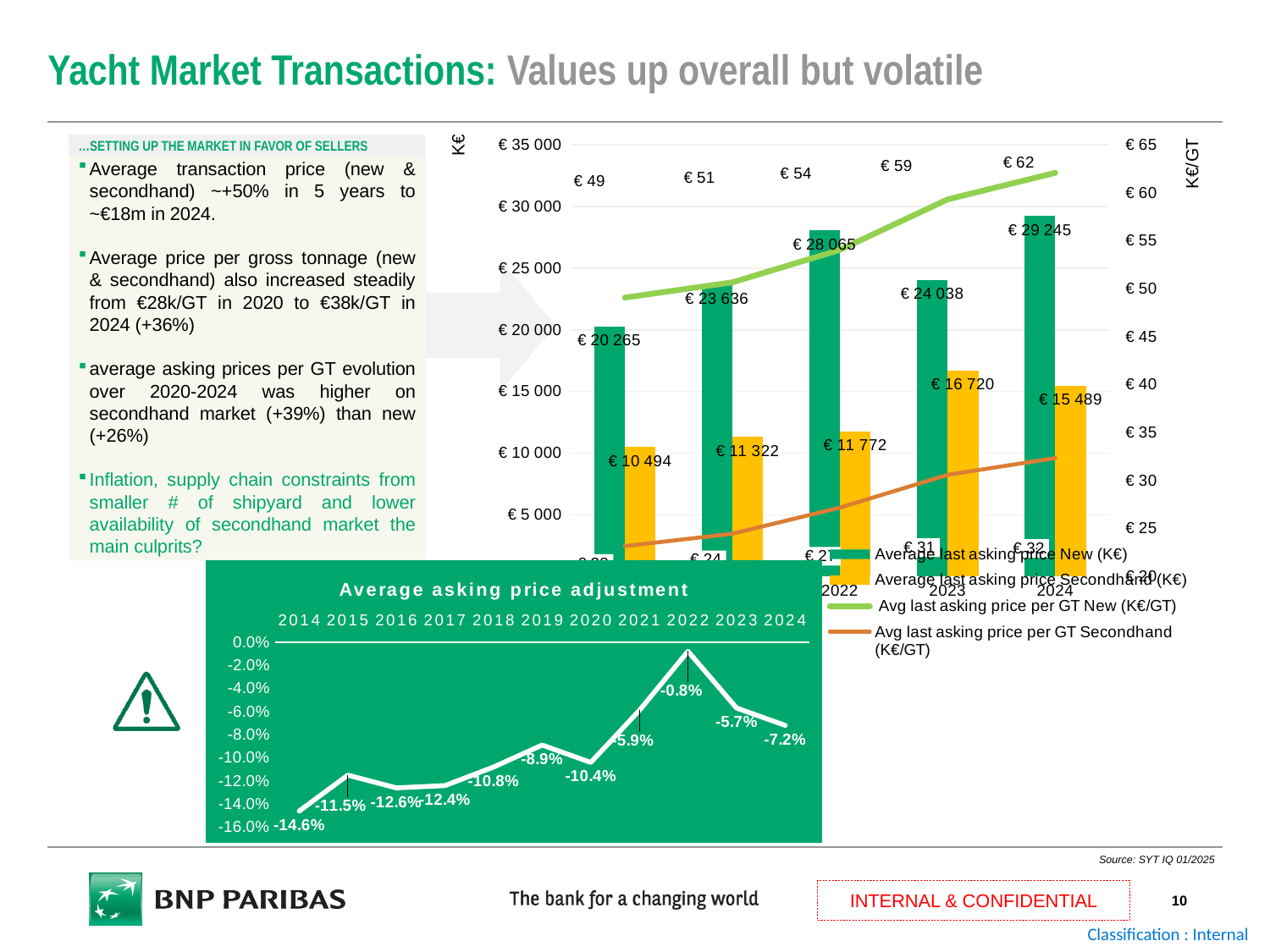
In the 'Average asking price adjustment' chart, which year has the lowest value? 2014 In the top chart, which year has the highest Average last asking price New bar? 2024 In the 'Average asking price adjustment' chart, what is the value for 2022? -0.8% In the top chart, what is the Avg last asking price per GT New (K€/GT) for 2024? € 62 In the top chart, what is the difference between the Average last asking price New and Secondhand in 2022? € 16 293 In the top chart, what is the Average last asking price New (K€) for 2024? € 29 245 What kind of chart is the 'Average asking price adjustment' chart? line chart Does the Avg last asking price per GT New line in the top chart rise or fall from left to right? rise In the 'Average asking price adjustment' chart, which year has the higher value, 2023 or 2024? 2023 How many years are plotted in the 'Average asking price adjustment' chart? 11 How many series does the legend of the top chart list? 4 In the top chart, what is the Average last asking price Secondhand (K€) for 2023? € 16 720